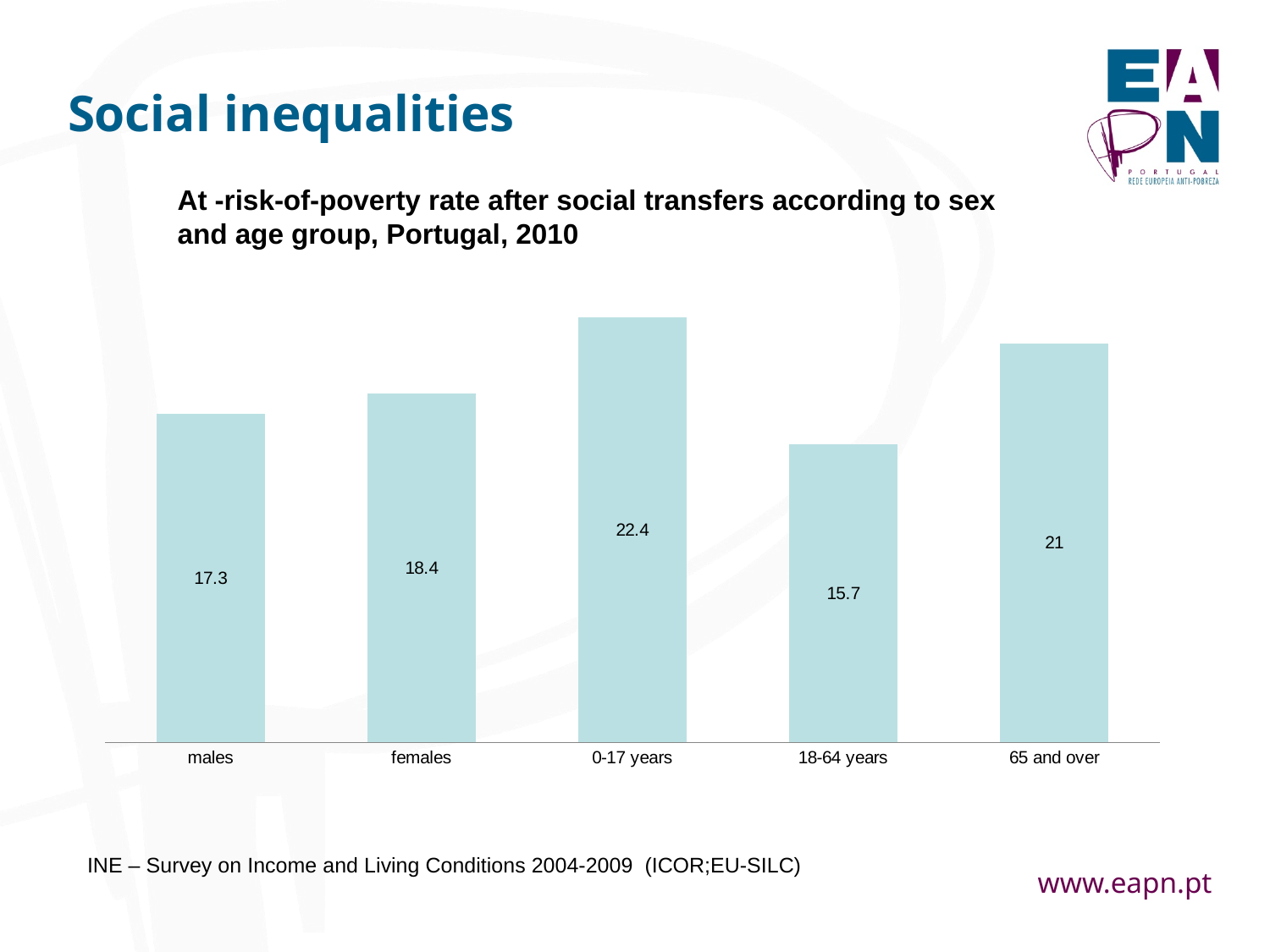
What is the difference between the rates for females and males? 1.1 Which is larger, the rate for 65 and over or the rate for females? 65 and over What is the value for the 0-17 years age group? 22.4 Which category has the highest at-risk-of-poverty rate? 0-17 years Which category has the lowest at-risk-of-poverty rate? 18-64 years What is the value for the 65 and over age group? 21 What kind of chart is shown on the slide? Bar chart What is the at-risk-of-poverty rate for males? 17.3 How many categories are shown in the chart? 5 What is the difference between the rates for 0-17 years and 18-64 years? 6.7 What is the at-risk-of-poverty rate for females? 18.4 What is the value for the 18-64 years age group? 15.7